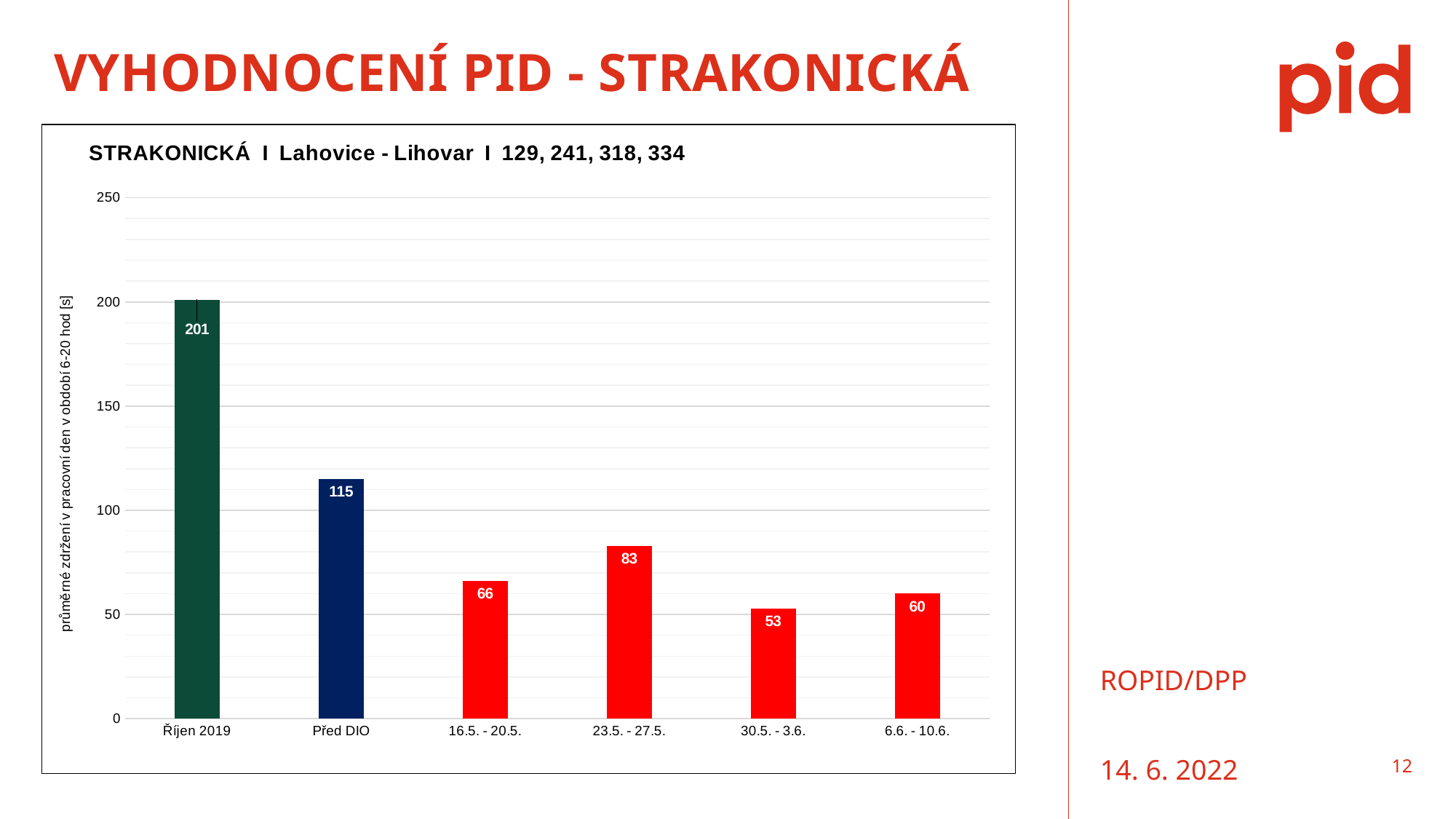
Which category has the lowest value? 30.5. - 3.6. What is the value for 23.5. - 27.5.? 83 What is the value for 30.5. - 3.6.? 53 How many categories are shown on the x axis? 6 What kind of chart is shown on the slide? bar chart What is the difference between the values for 23.5. - 27.5. and 16.5. - 20.5.? 17 What is the value for Říjen 2019? 201 What is the title of the chart? STRAKONICKÁ I Lahovice - Lihovar I 129, 241, 318, 334 What is the value for Před DIO? 115 Which is larger, the value for 16.5. - 20.5. or the value for 6.6. - 10.6.? 16.5. - 20.5. Which category has the highest value? Říjen 2019 What is the difference between the values for Říjen 2019 and Před DIO? 86